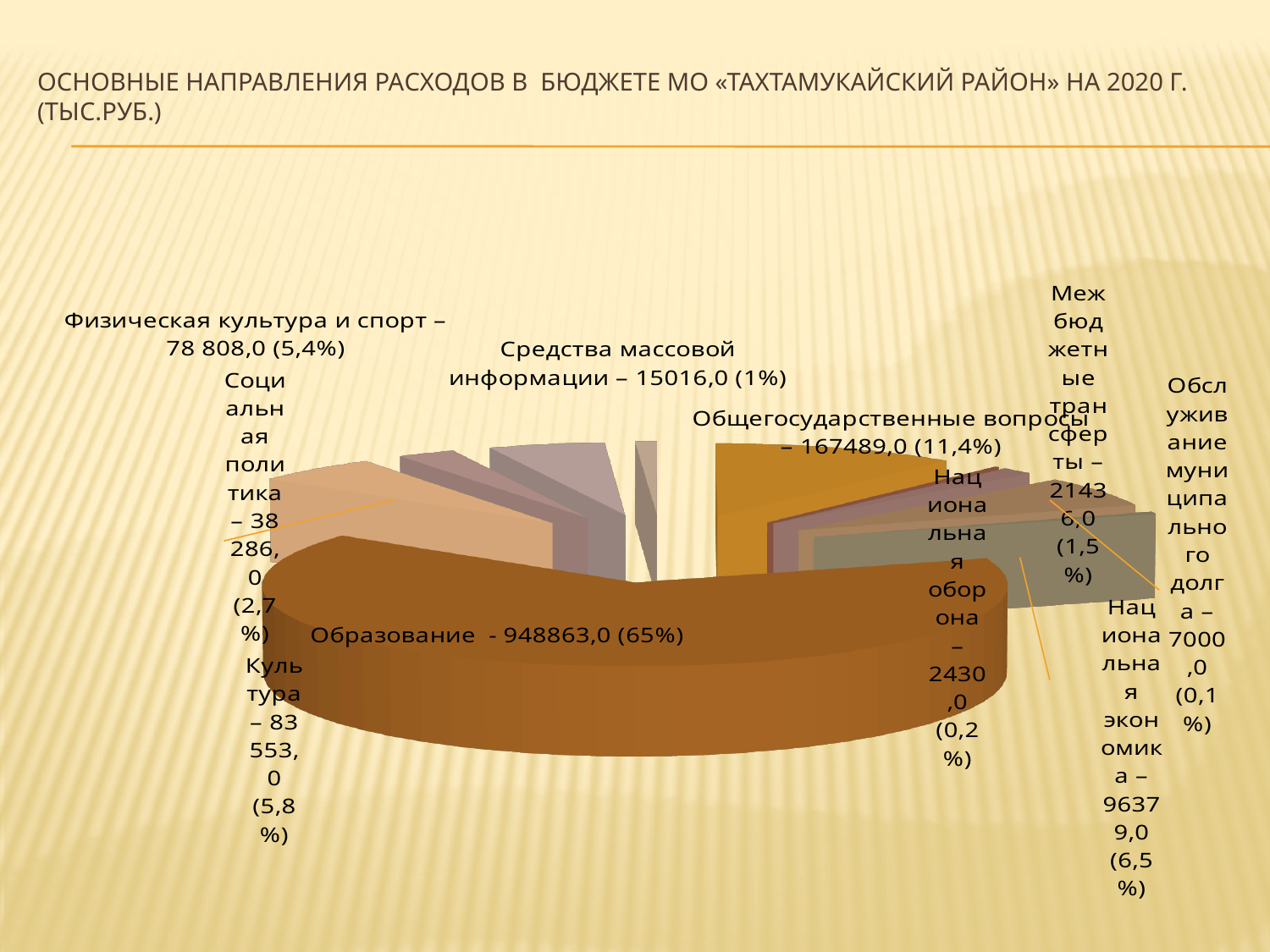
What is the value shown for Общегосударственные вопросы? 167489,0 What kind of chart is shown on the slide? Pie chart How many categories are shown in the pie chart? 10 What share of the pie does Межбюджетные трансферты represent? 1,5% What share of the pie does Культура represent? 5,8% What is the difference between the values for Общегосударственные вопросы and Национальная экономика? 71110,0 What is the value shown for Образование? 948863,0 What is the value shown for Национальная оборона? 2430,0 Which category has the smallest share of the pie? Национальная оборона Which category has the largest share of the pie? Образование What is the title of the chart on the slide? Основные направления расходов в бюджете МО «Тахтамукайский район» на 2020 г. (тыс.руб.) Which is larger: Физическая культура и спорт or Социальная политика? Физическая культура и спорт